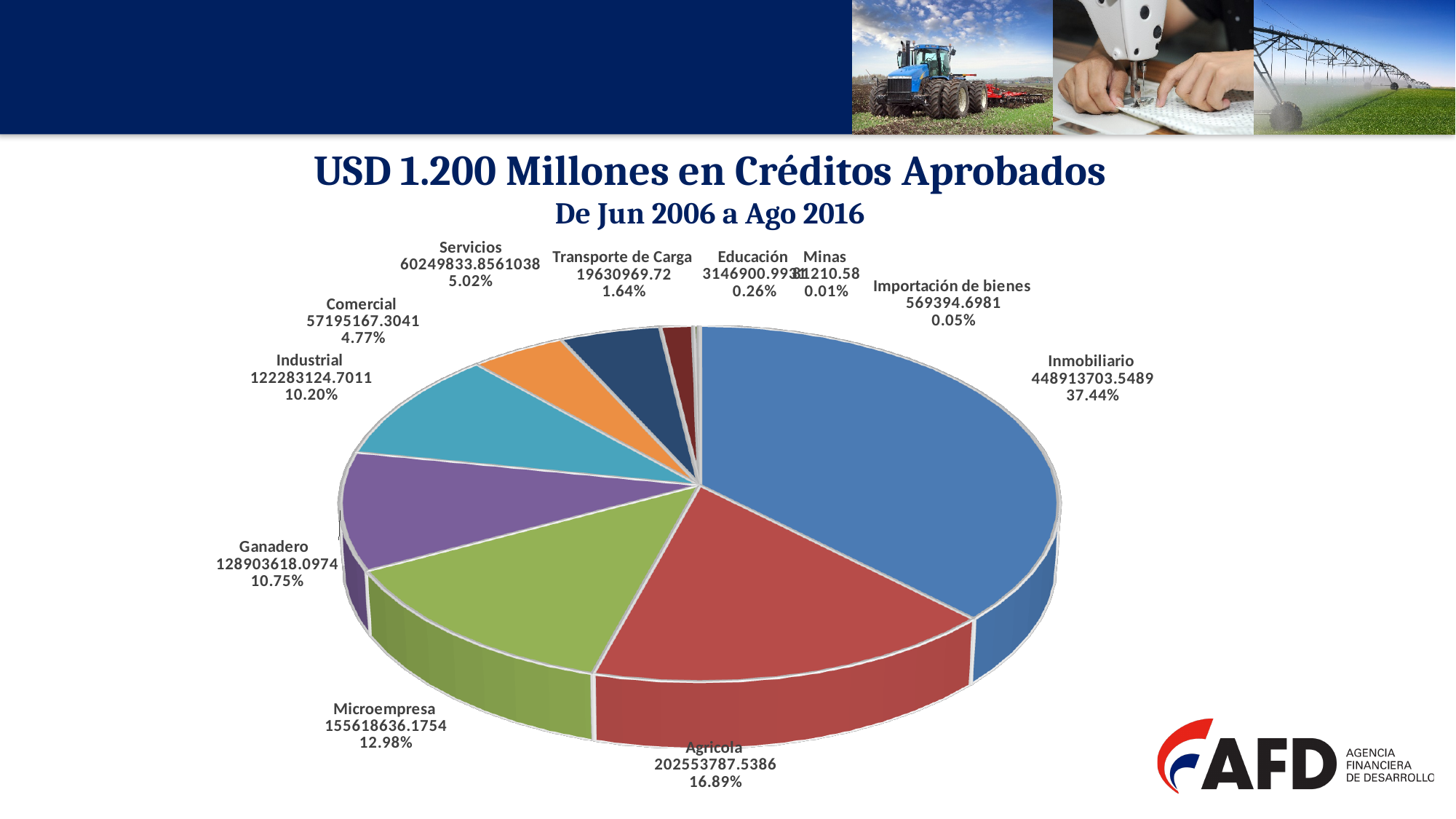
What kind of chart is shown on the slide? pie chart What share of the pie does Transporte de Carga represent? 1.64% What share of the pie does Agricola represent? 16.89% What share of the pie does Inmobiliario represent? 37.44% Which category has the largest share of the pie? Inmobiliario What is the value shown for Ganadero? 128903618.0974 How many categories are shown in the pie chart? 11 What is the value shown for Microempresa? 155618636.1754 What is the title of the chart on the slide? USD 1.200 Millones en Créditos Aprobados What is the difference in percentage share between Inmobiliario and Agricola? 20.55% Which category has the smallest share of the pie? Minas Which has a larger share, Servicios or Comercial? Servicios